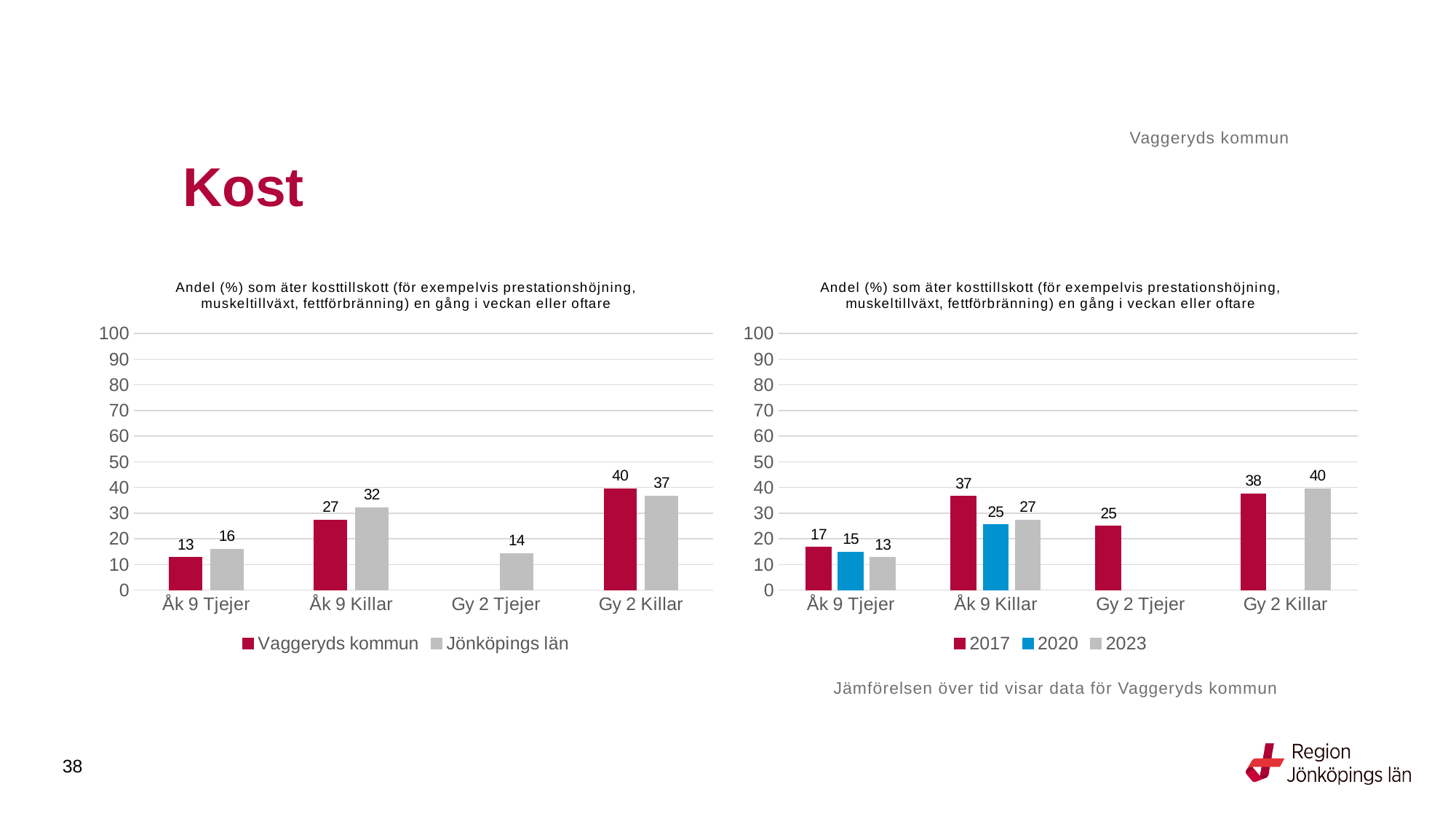
In the right chart, what is the difference between 2017 and 2023 for Åk 9 Killar? 10 In the left chart, how many series does the legend list? 2 What kind of chart is the right chart? Bar chart In the left chart, what is the difference between Vaggeryds kommun and Jönköpings län for Gy 2 Killar? 3 In the left chart, what is the value for Jönköpings län for Gy 2 Tjejer? 14 In the left chart, what is the value for Vaggeryds kommun for Åk 9 Killar? 27 In the right chart, what is the value for 2017 for Gy 2 Tjejer? 25 In the left chart, which is larger for Åk 9 Tjejer: Vaggeryds kommun or Jönköpings län? Jönköpings län In the left chart, which category has the highest value for Jönköpings län? Gy 2 Killar In the right chart, which year has the lowest value for Åk 9 Tjejer? 2023 In the right chart, how many series does the legend list? 3 In the right chart, what is the value for 2020 for Åk 9 Killar? 25